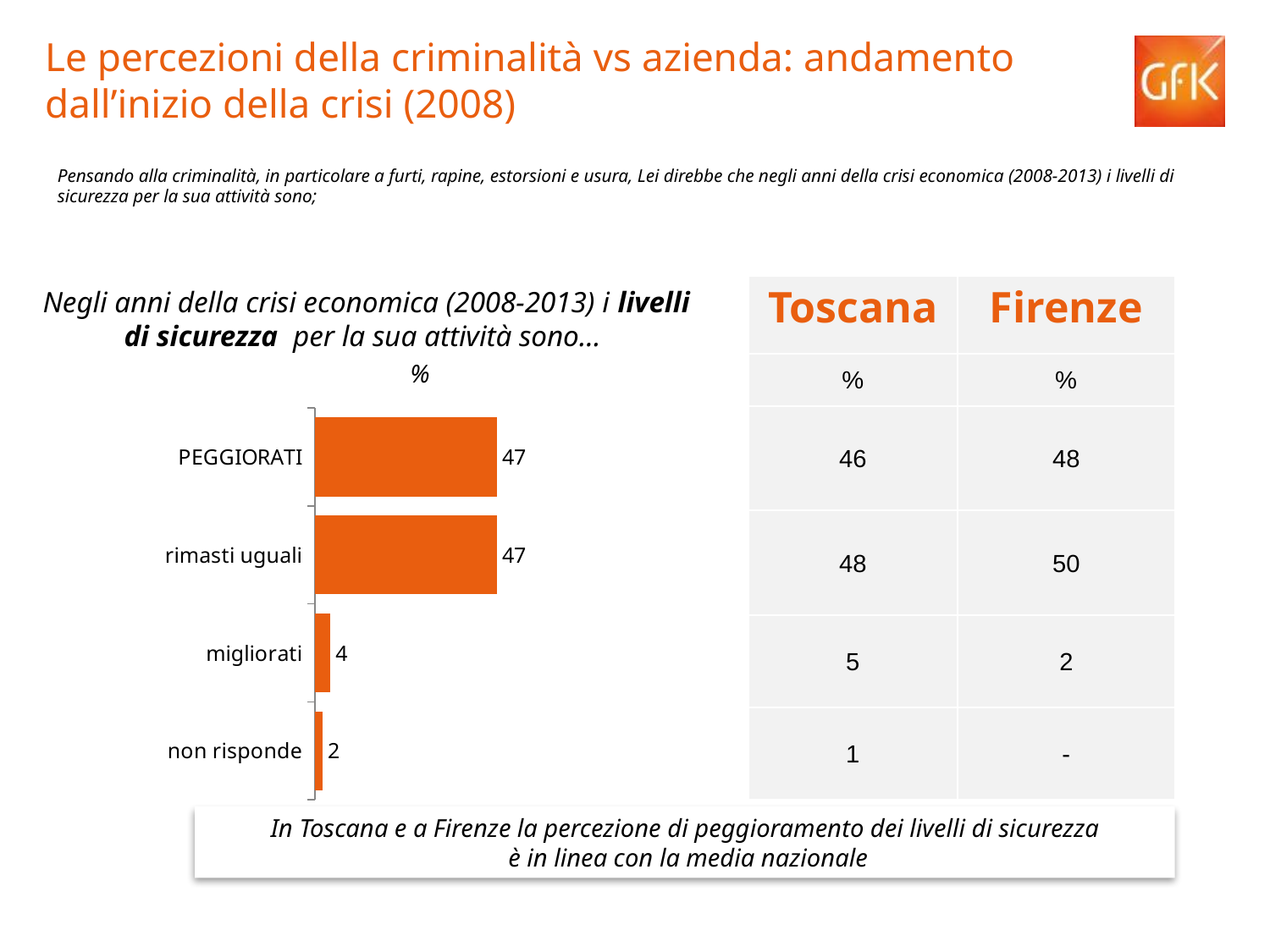
Which category has the lowest value in the bar chart? non risponde What value does the bar chart show for non risponde? 2 What value does the bar chart show for migliorati? 4 Which is larger in the bar chart, the value for rimasti uguali or the value for migliorati? rimasti uguali How many categories are shown in the bar chart? 4 What value does the bar chart show for rimasti uguali? 47 What is the difference between the values for migliorati and non risponde in the bar chart? 2 What value does the bar chart show for PEGGIORATI? 47 What colour are the bars in the chart? orange What kind of chart is shown on the slide? bar chart Which is larger in the bar chart, the value for migliorati or the value for non risponde? migliorati What is the difference between the values for PEGGIORATI and migliorati in the bar chart? 43